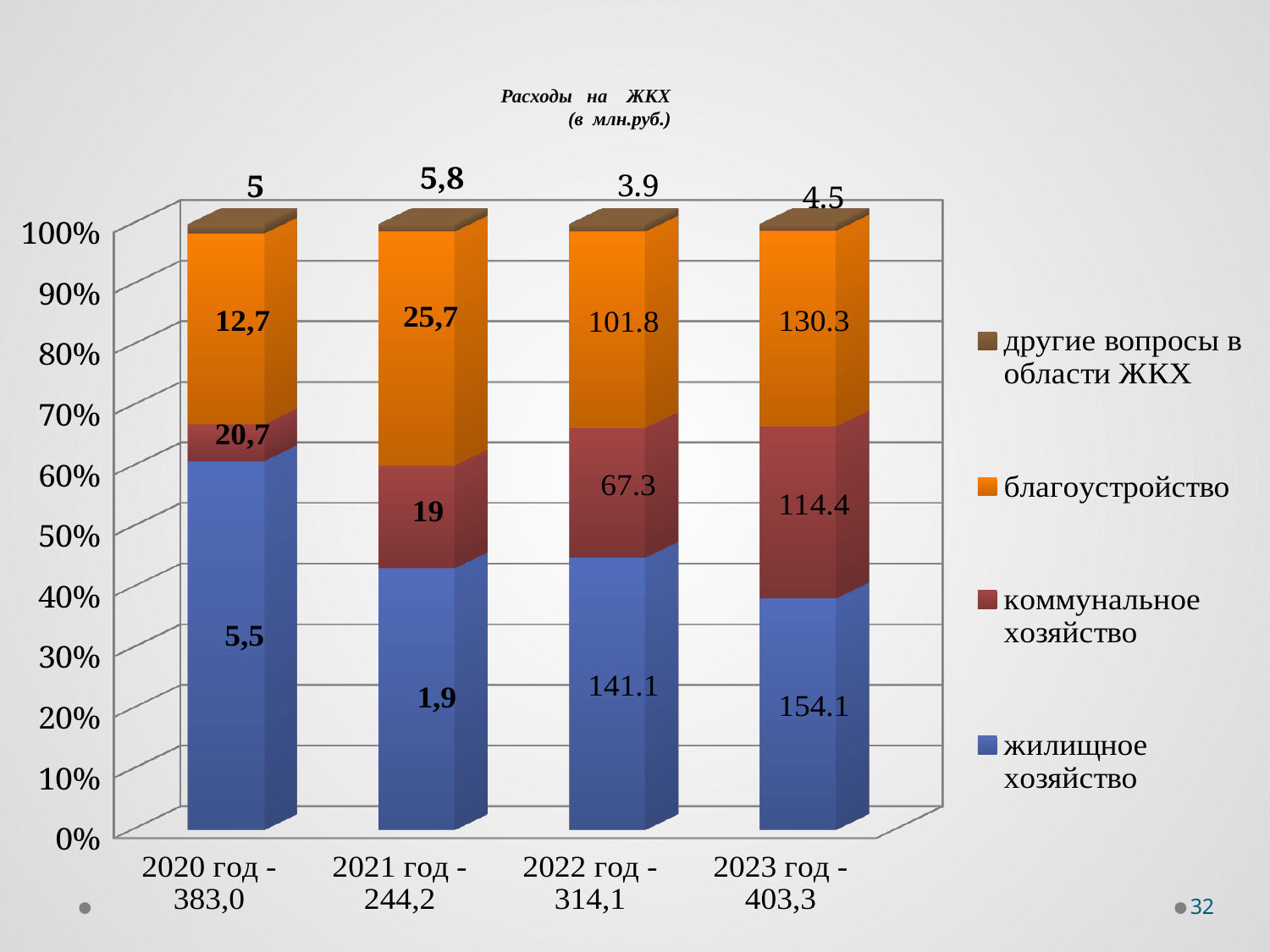
Is the share of жилищное хозяйство in the 2020 bar greater or less than 50%? greater What is the difference between the жилищное хозяйство labels for 2023 (154.1) and 2022 (141.1)? 13 How many year categories are shown on the x axis? 4 Which year has the highest data label for благоустройство? 2023 год What is the data label for благоустройство in the 2022 bar? 101.8 Which is larger: the коммунальное хозяйство label for 2023 or for 2022? 2023 What is the data label for жилищное хозяйство in the 2023 bar? 154.1 What kind of chart is shown on the slide? Stacked bar chart What is the data label for другие вопросы в области ЖКХ in the 2020 bar? 5 What is the data label for коммунальное хозяйство in the 2021 bar? 19 What total value is printed in the category label for 2023 год? 403,3 How many series does the legend list? 4